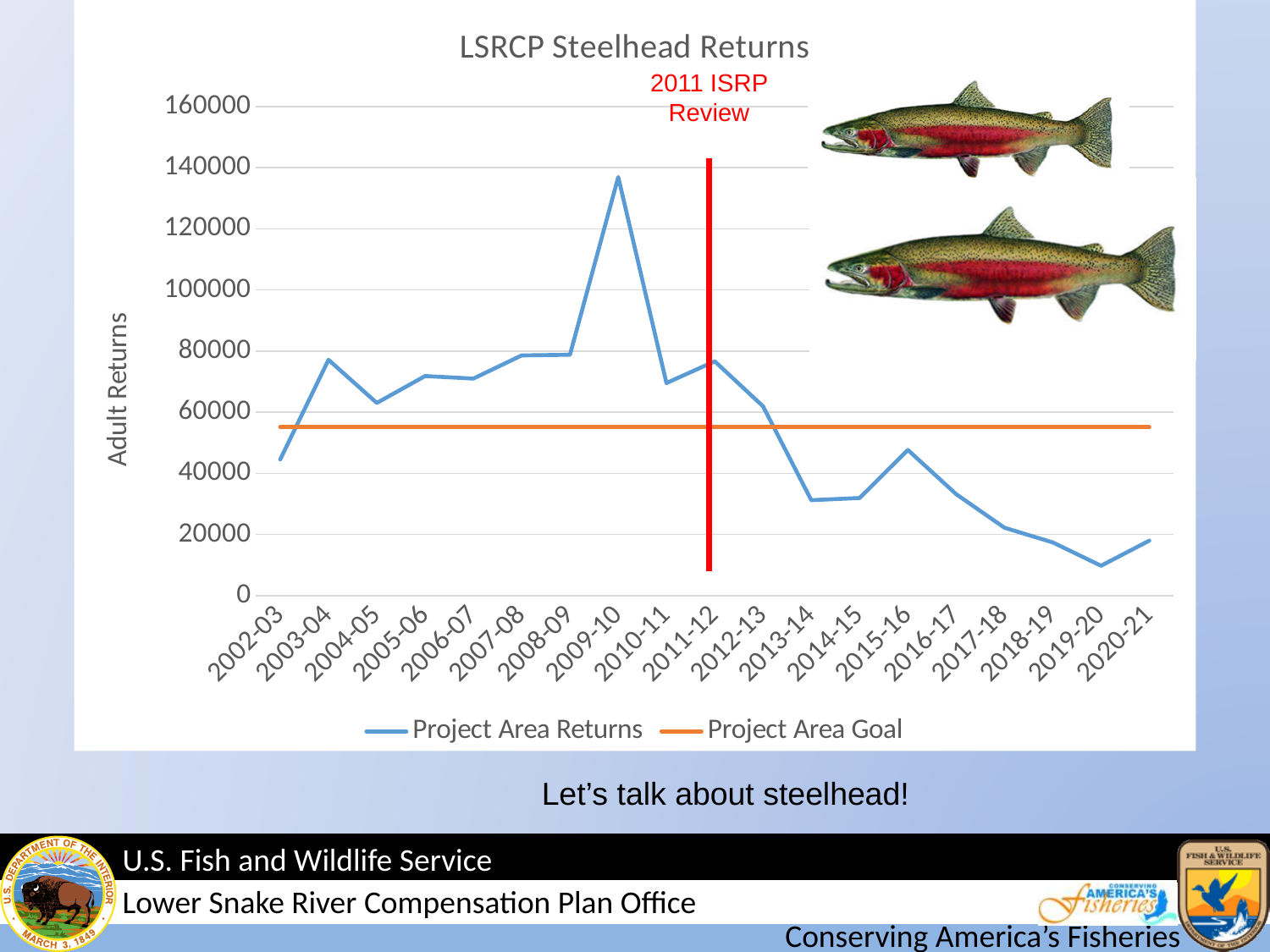
What label is attached to the red vertical line on the chart? 2011 ISRP Review Is the Project Area Returns value for 2009-10 greater or less than 120000? greater Which year has the larger Project Area Returns value, 2003-04 or 2013-14? 2003-04 In which year is the Project Area Returns value highest? 2009-10 Do the Project Area Returns values rise or fall from 2015-16 to 2019-20? fall How many series does the legend list? 2 What kind of chart is shown on the slide? Line chart How many year categories are shown on the x axis? 19 In which year is the Project Area Returns value lowest? 2019-20 What is the title of the chart? LSRCP Steelhead Returns Is the Project Area Returns value for 2002-03 greater or less than 60000? less Is the Project Area Returns value for 2019-20 greater or less than 20000? less